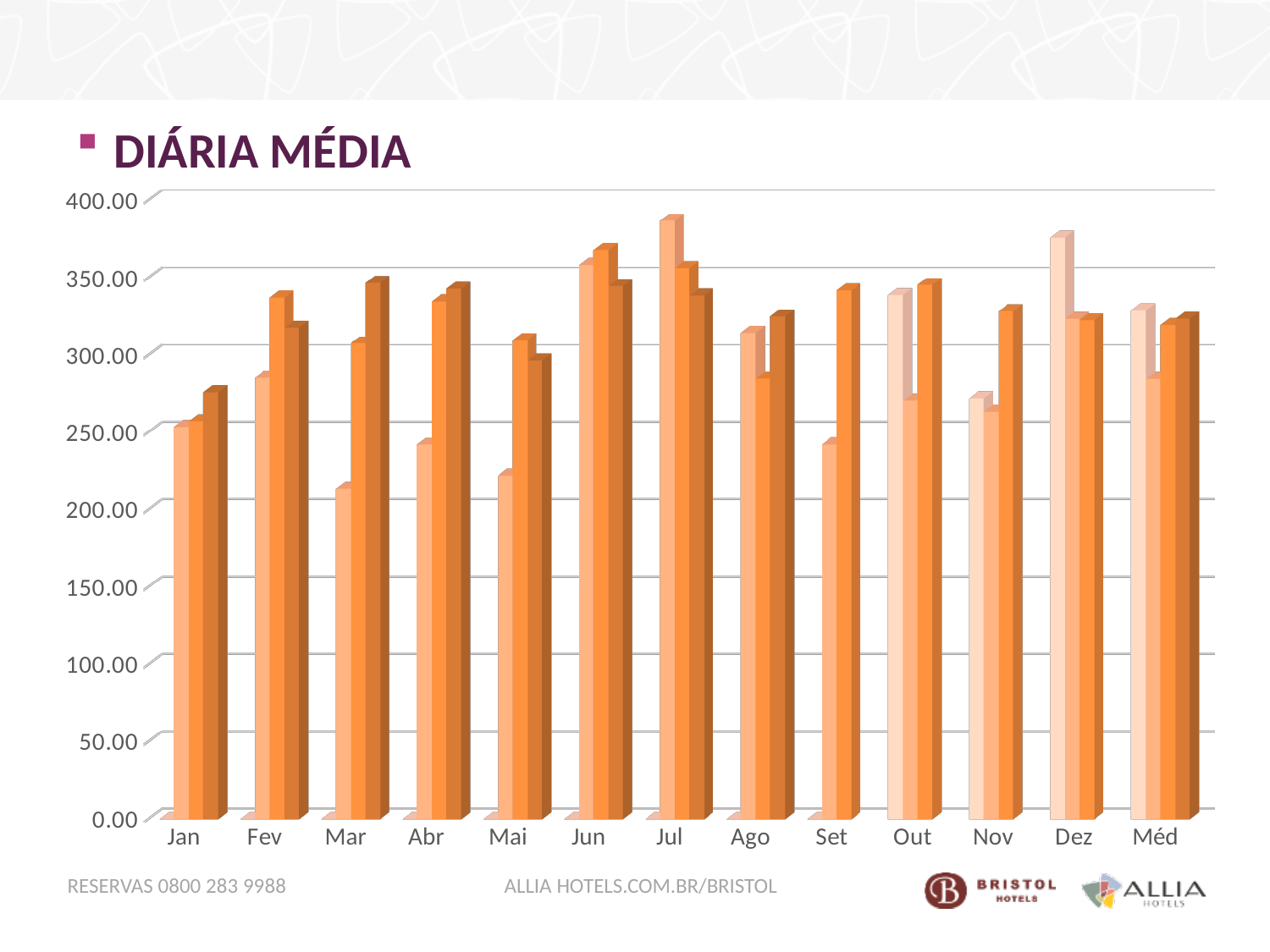
What kind of chart is shown on the slide? bar chart Is the value of the leftmost bar for Mai greater or less than 250? less Which is larger: the leftmost bar for Jul or the leftmost bar for Jan? Jul What is the title of the chart? DIÁRIA MÉDIA Is the value of the leftmost bar for Nov greater or less than 300? less How many categories are shown along the x axis of the chart? 13 Is the value of the tallest bar for Jul greater or less than 350? greater What is the highest value shown on the vertical axis of the chart? 400.00 Which month has the tallest bar on the chart? Jul